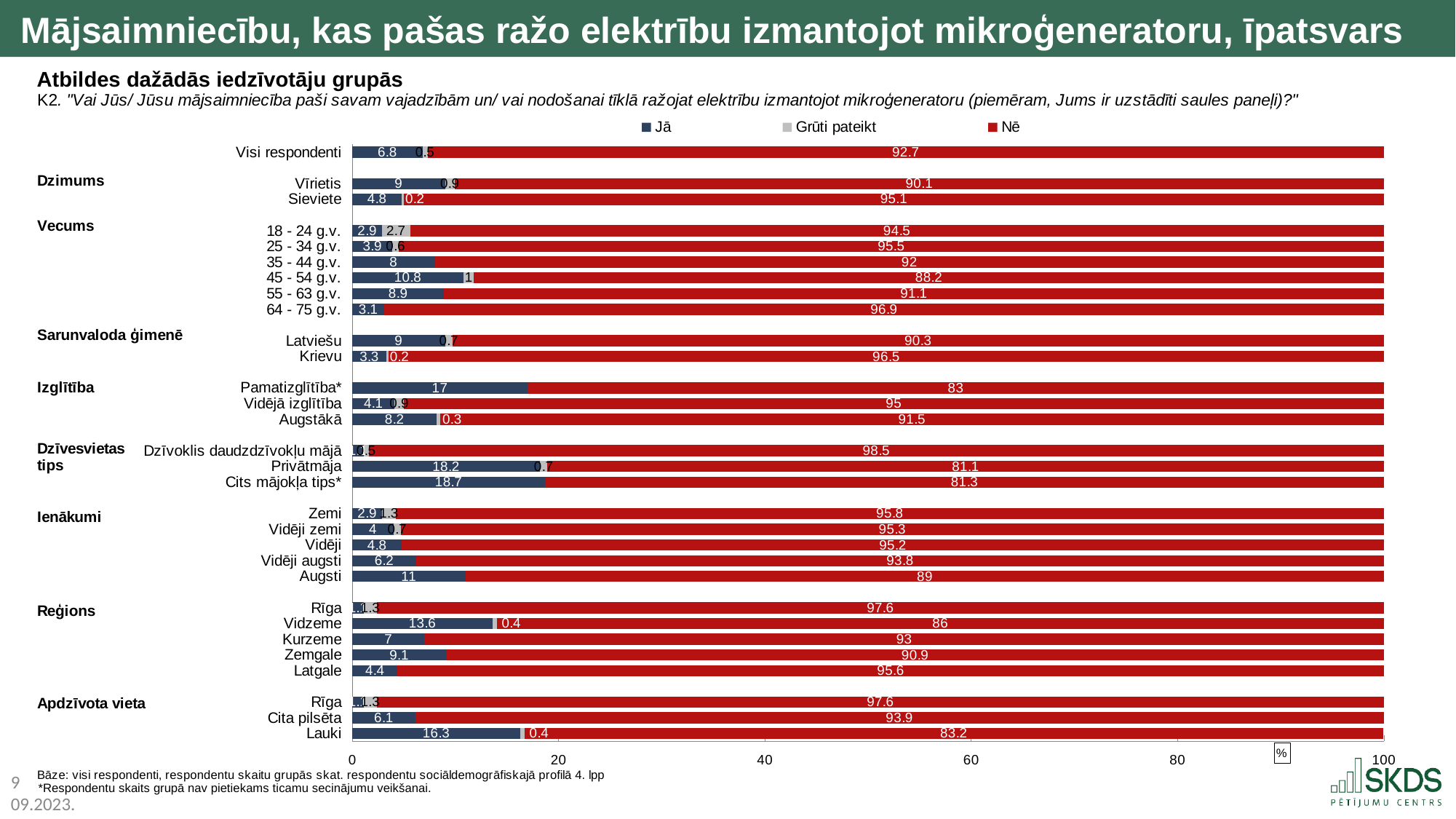
What kind of chart is shown on the slide? Stacked bar chart Within the "Reģions" group, which category has the highest "Jā" value? Vidzeme What is the value of "Grūti pateikt" for "18 - 24 g.v."? 2.7 What is the value of "Nē" for "Pamatizglītība*"? 83 What are the three legend entries of the chart? Jā, Grūti pateikt, Nē Within the "Apdzīvota vieta" group, which category has the lowest "Nē" value? Lauki What is the difference between the "Jā" values for "Vīrietis" and "Sieviete"? 4.2 What is the value of "Jā" for "Visi respondenti"? 6.8 Within the "Vecums" group, which category has the highest "Jā" value? 45 - 54 g.v. How many series does the legend list? 3 Which has a larger "Jā" value, "Latviešu" or "Krievu"? Latviešu What is the value of "Nē" for "Lauki"? 83.2